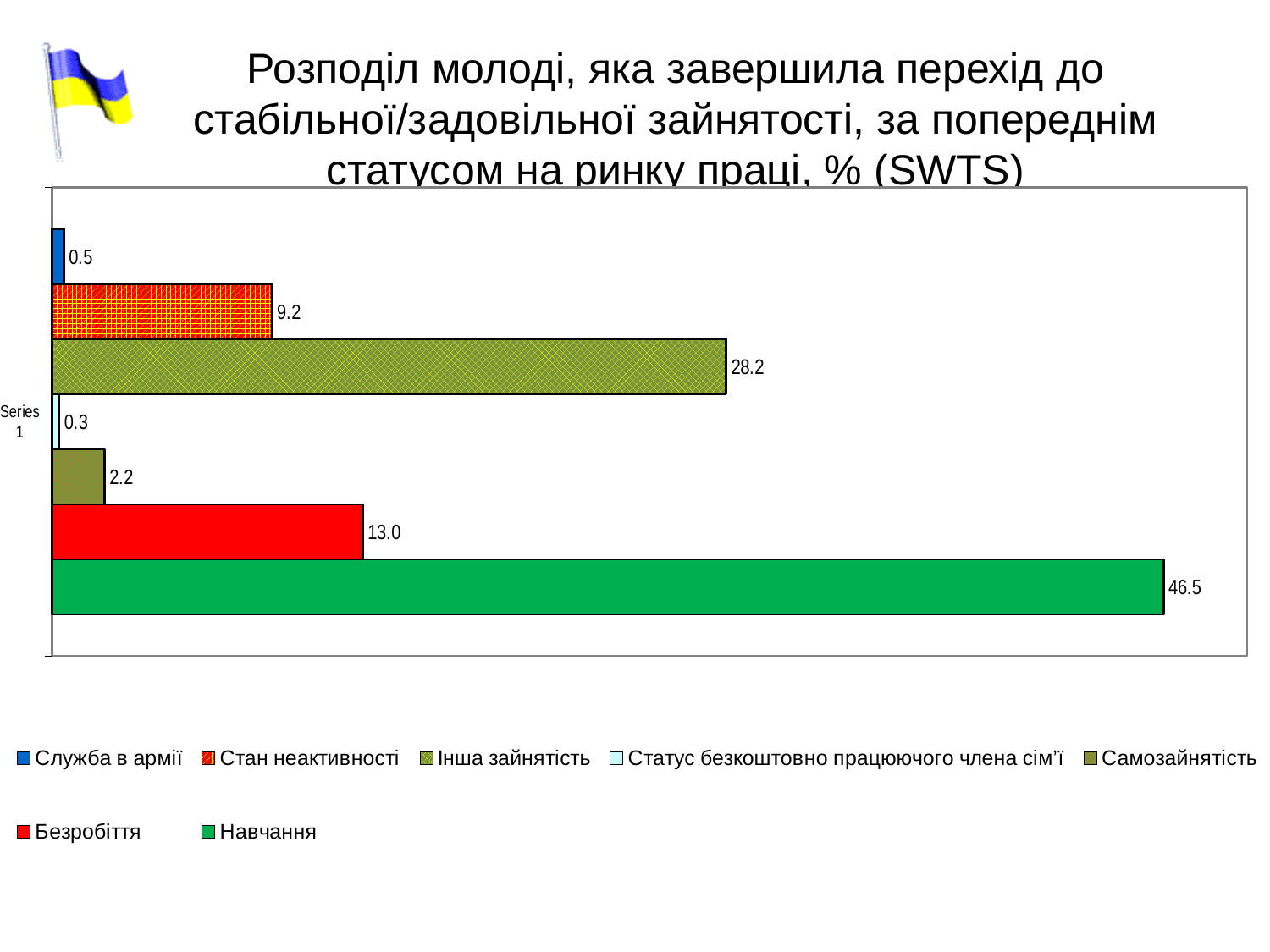
What value is shown for Безробіття? 13.0 What value is shown for Інша зайнятість? 28.2 Which series has the highest value? Навчання What value is shown for Стан неактивності? 9.2 What kind of chart is shown on the slide? Bar chart What colour is the bar for Навчання? Green Which series has the lowest value? Статус безкоштовно працюючого члена сім'ї What value is shown for Навчання? 46.5 What is the difference between the values for Навчання and Інша зайнятість? 18.3 Which is larger, the value for Безробіття or the value for Стан неактивності? Безробіття What value is shown for Статус безкоштовно працюючого члена сім'ї? 0.3 How many series does the legend list? 7